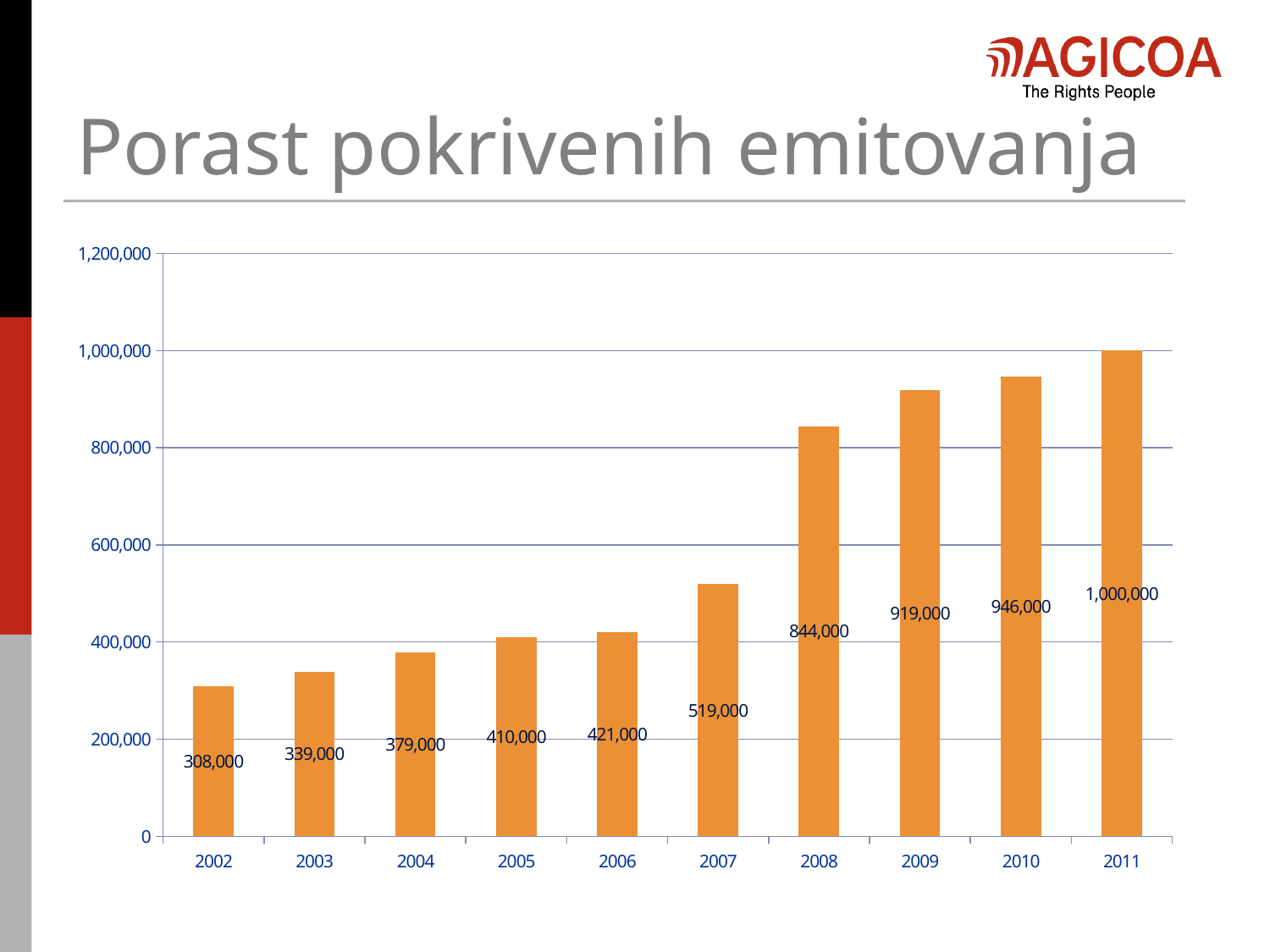
Do the values rise or fall from 2002 to 2011? Rise Is the value for 2008 greater or less than 800,000? greater How many years are shown on the x axis? 10 What kind of chart is shown on the slide? Bar chart Which is larger, the value for 2009 or the value for 2006? 2009 What is the value for 2010? 946,000 What is the difference between the values for 2011 and 2002? 692,000 What is the value for 2002? 308,000 What is the difference between the values for 2008 and 2007? 325,000 Which year has the highest value? 2011 Which year has the lowest value? 2002 What is the value for 2007? 519,000